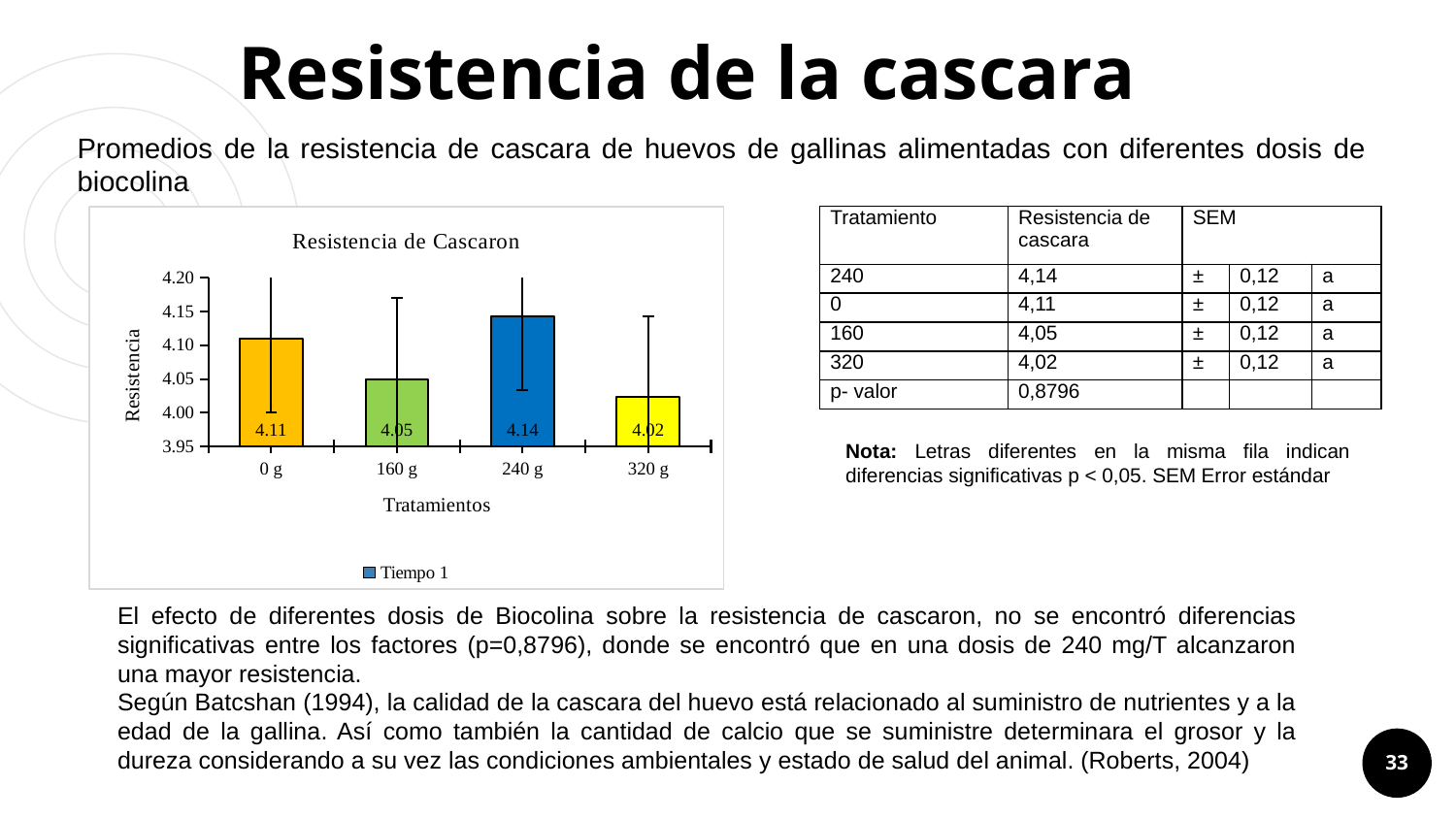
Is the value for 160 g in the Resistencia de Cascaron chart greater or less than 4.10? less What is the value for the 320 g treatment in the Resistencia de Cascaron chart? 4.02 How many series does the legend of the Resistencia de Cascaron chart list? 1 How many treatment categories are shown in the Resistencia de Cascaron chart? 4 Which treatment has the highest value in the Resistencia de Cascaron chart? 240 g Which has a larger value in the Resistencia de Cascaron chart, 0 g or 160 g? 0 g Which treatment has the lowest value in the Resistencia de Cascaron chart? 320 g What is the difference between the values for 240 g and 320 g in the Resistencia de Cascaron chart? 0.12 What is the value for the 240 g treatment in the Resistencia de Cascaron chart? 4.14 What type of chart is the Resistencia de Cascaron chart? Bar chart What is the label of the y axis in the Resistencia de Cascaron chart? Resistencia What is the value for the 0 g treatment in the Resistencia de Cascaron chart? 4.11